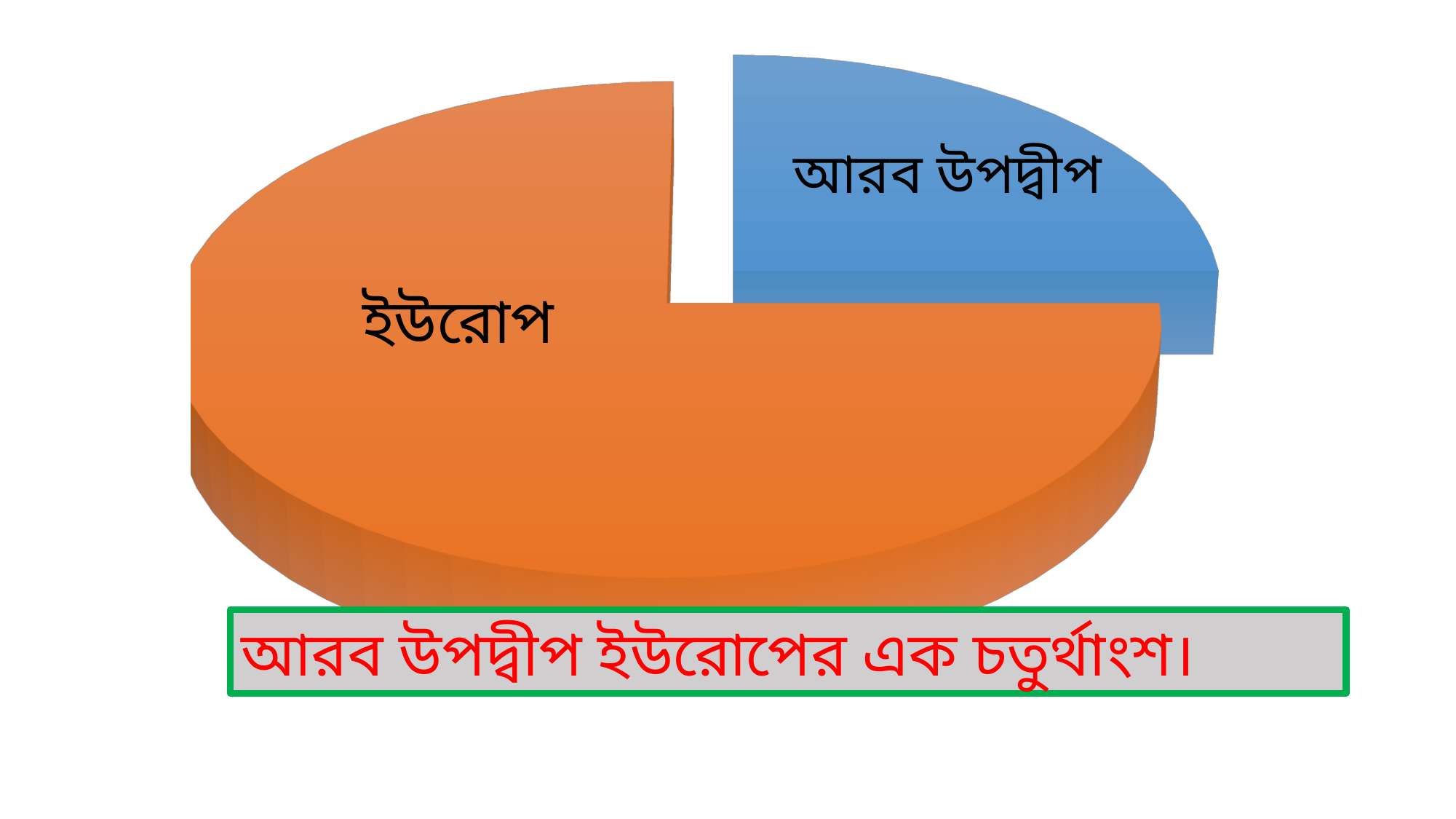
Which is larger in the pie chart, ইউরোপ or আরব উপদ্বীপ? ইউরোপ How many slices does the pie chart have? 2 Which slice of the pie chart is the smallest? আরব উপদ্বীপ Which slice of the pie chart is the largest? ইউরোপ Which slice of the pie chart is coloured blue? আরব উপদ্বীপ What kind of chart is shown on the slide? Pie chart What colour is the ইউরোপ slice of the pie chart? Orange Which slice of the pie chart is pulled out (exploded) from the rest of the pie? আরব উপদ্বীপ